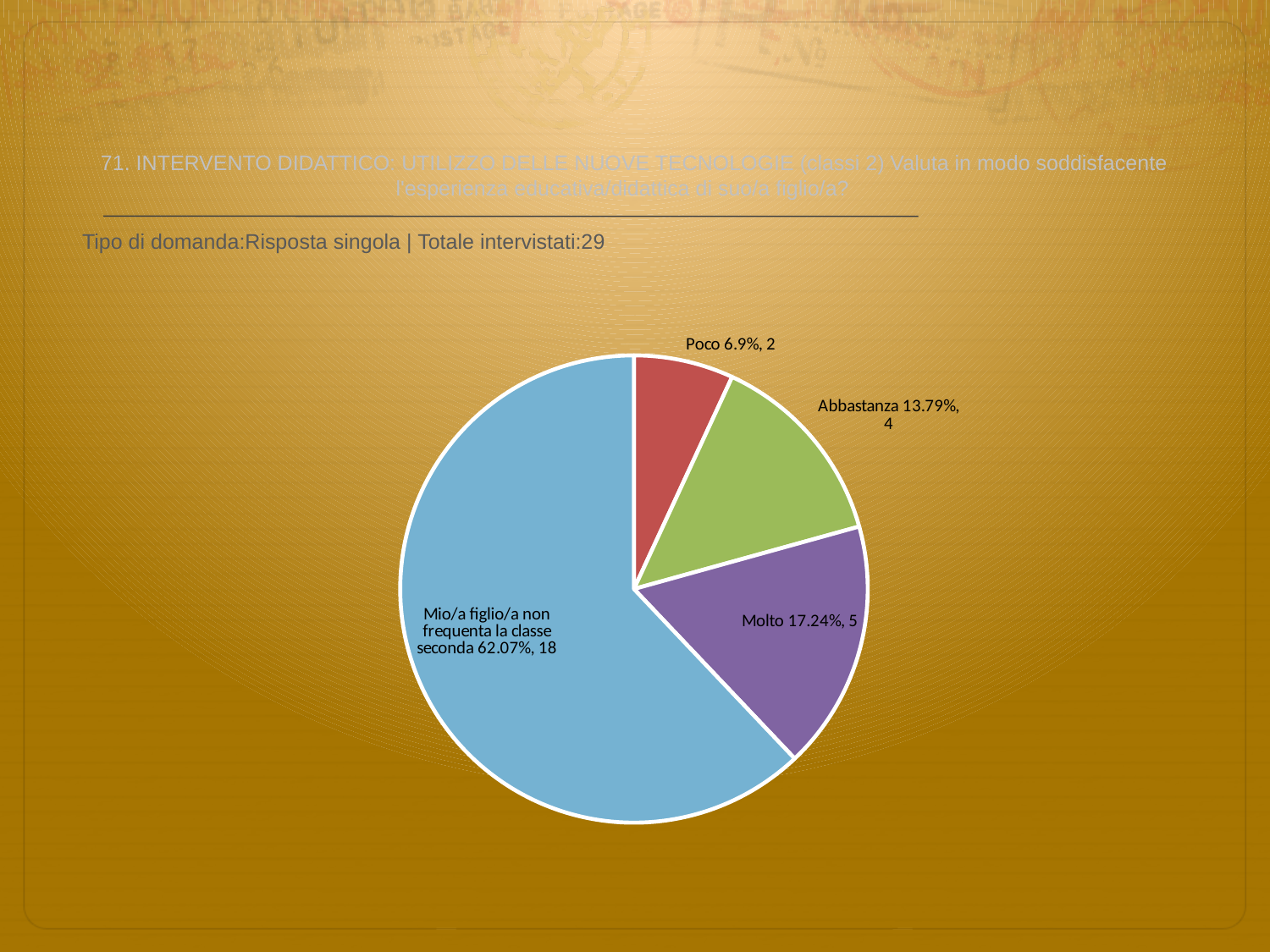
What percentage is shown for the "Poco" slice? 6.9% Which slice is the largest? Mio/a figlio/a non frequenta la classe seconda Which slice is the smallest? Poco What percentage is shown for the "Molto" slice? 17.24% What colour is the "Molto" slice? purple How many slices does the pie chart have? 4 How many respondents are in the "Mio/a figlio/a non frequenta la classe seconda" slice? 18 How many respondents chose "Abbastanza"? 4 Which is larger, the "Molto" slice or the "Abbastanza" slice? Molto What is the difference in respondent count between "Molto" and "Poco"? 3 What share of the pie does the "Abbastanza" slice represent? 13.79% What kind of chart is shown on the slide? pie chart